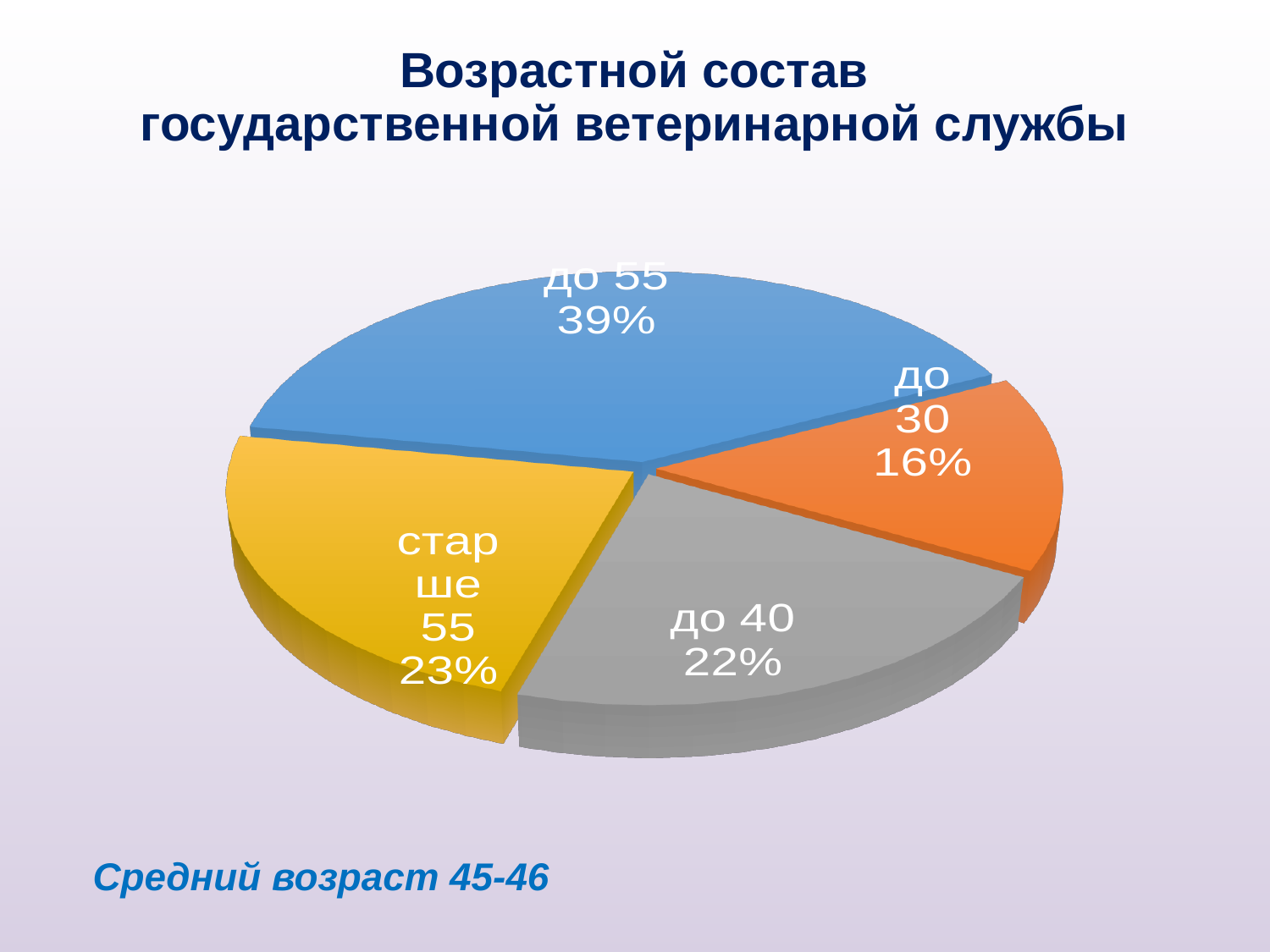
What is the difference in percentage points between the 'до 55' and 'до 30' slices? 23 What is the title of the slide? Возрастной состав государственной ветеринарной службы Which age group has the smallest share of the pie? до 30 What share of the pie does the 'до 30' slice represent? 16% Which slice is larger, 'до 40' or 'до 30'? до 40 What share of the pie does the 'до 40' slice represent? 22% Which age group has the largest share of the pie? до 55 How many slices does the pie chart have? 4 What share of the pie does the 'до 55' slice represent? 39% What kind of chart is shown on the slide? Pie chart What is the difference in percentage points between the 'старше 55' and 'до 40' slices? 1